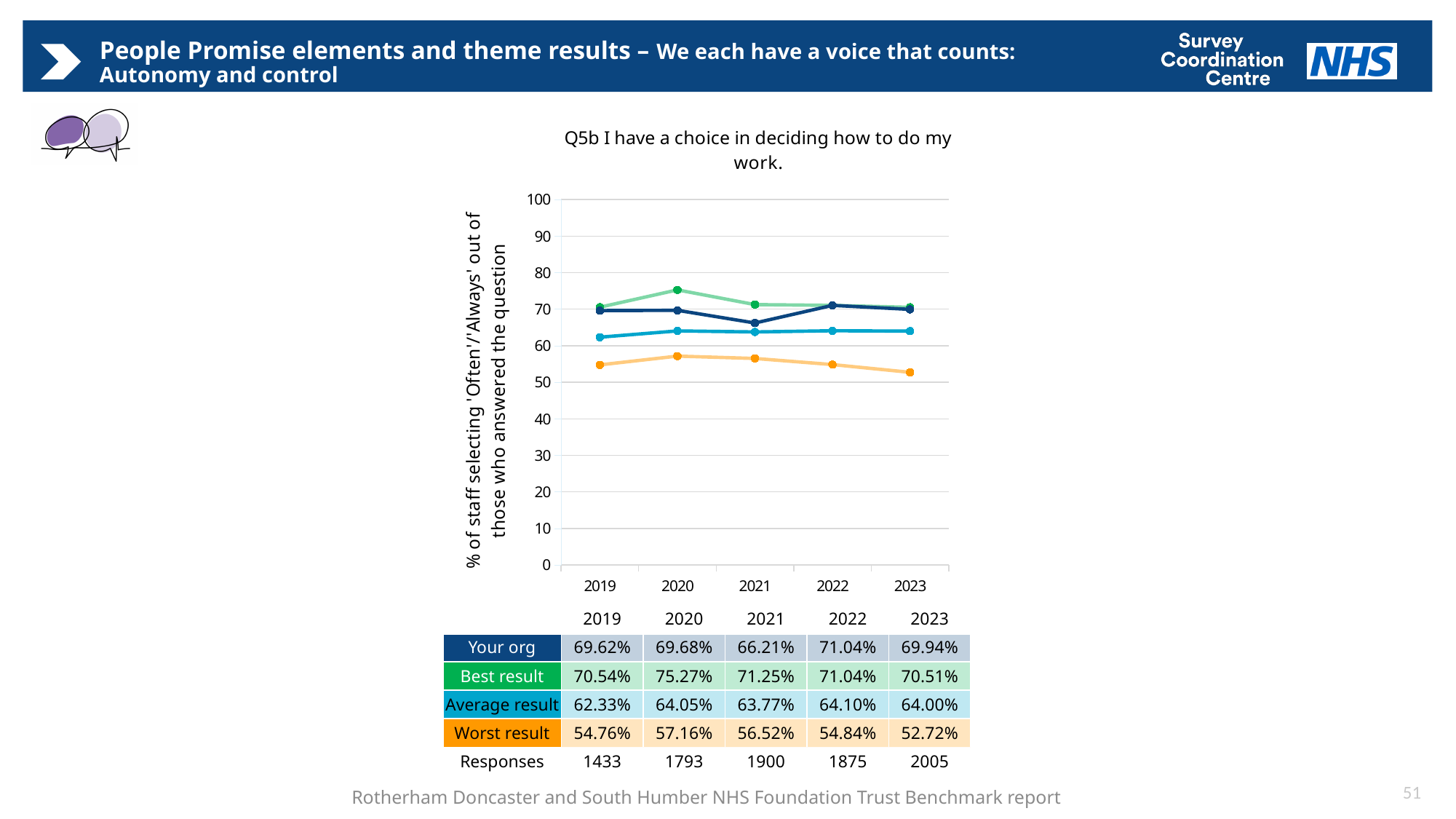
How many responses were recorded in 2023? 2005 What was the 'Your org' value for Q5b in 2022? 71.04% What is the difference between the 'Best result' and 'Your org' values in 2020? 5.59 percentage points What was the 'Worst result' value in 2023? 52.72% In which year was the 'Best result' value highest? 2020 Is the 'Your org' value for 2021 greater or less than 70? less Which is larger in 2023: the 'Your org' value or the 'Average result' value? Your org What type of chart is shown on the slide? Line chart In which year was the 'Your org' value lowest? 2021 Does the 'Worst result' line rise or fall from 2020 to 2023? Fall How many years are plotted on the x axis? 5 What was the 'Average result' value in 2019? 62.33%